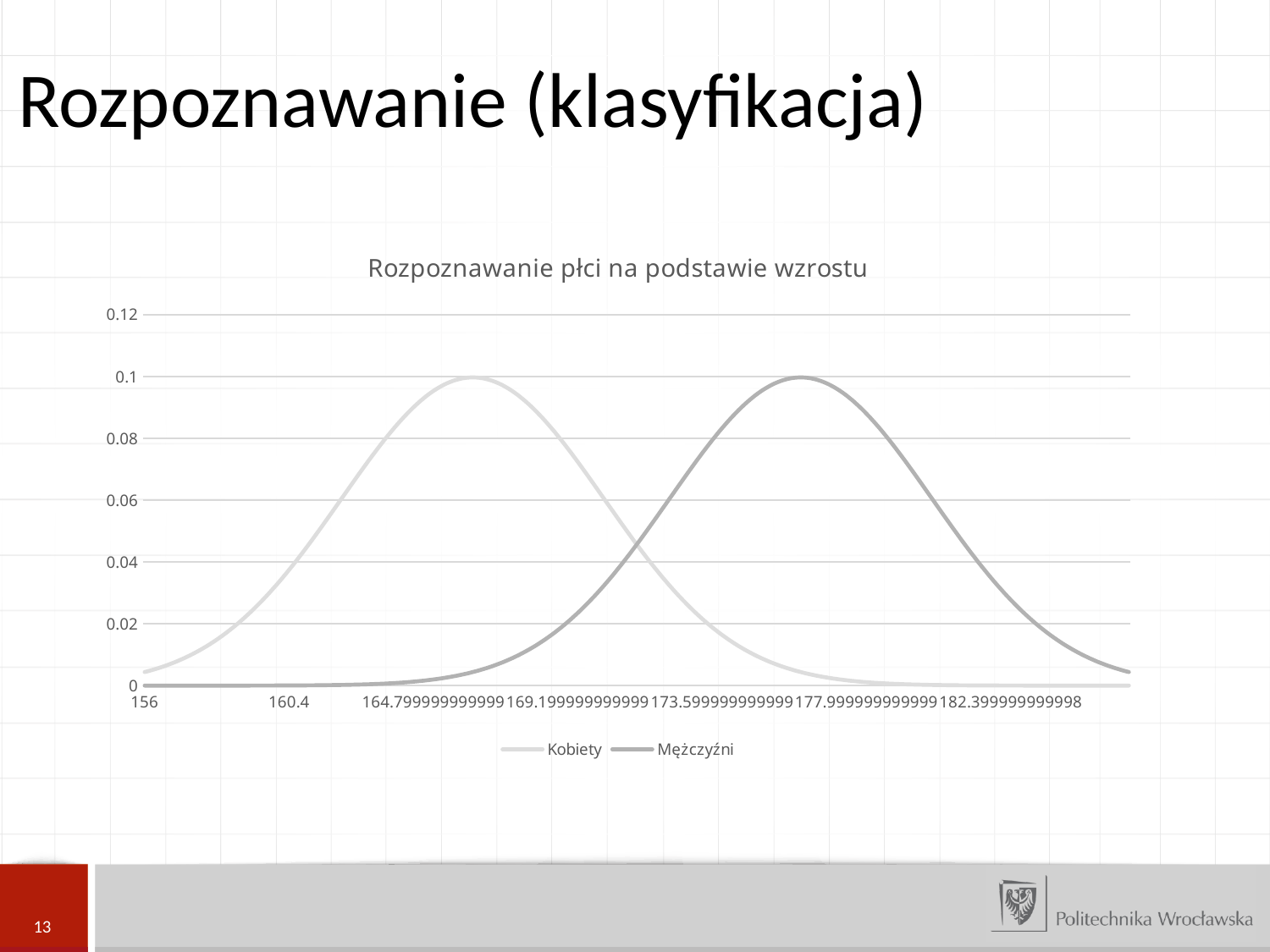
At 164.799999999999, which series has the larger value, Kobiety or Mężczyźni? Kobiety Is the value for Kobiety at 164.799999999999 greater or less than 0.08? greater What is the title of the chart? Rozpoznawanie płci na podstawie wzrostu How many tick labels are shown on the x axis? 7 Is the value for Kobiety at 182.399999999998 greater or less than 0.02? less What kind of chart is shown on the slide? line chart Is the value for Mężczyźni at 164.799999999999 greater or less than 0.02? less Does the Mężczyźni line rise or fall between 177.999999999999 and 182.399999999998? fall What are the two series named in the legend? Kobiety and Mężczyźni How many series does the legend list? 2 At 177.999999999999, which series has the larger value, Kobiety or Mężczyźni? Mężczyźni